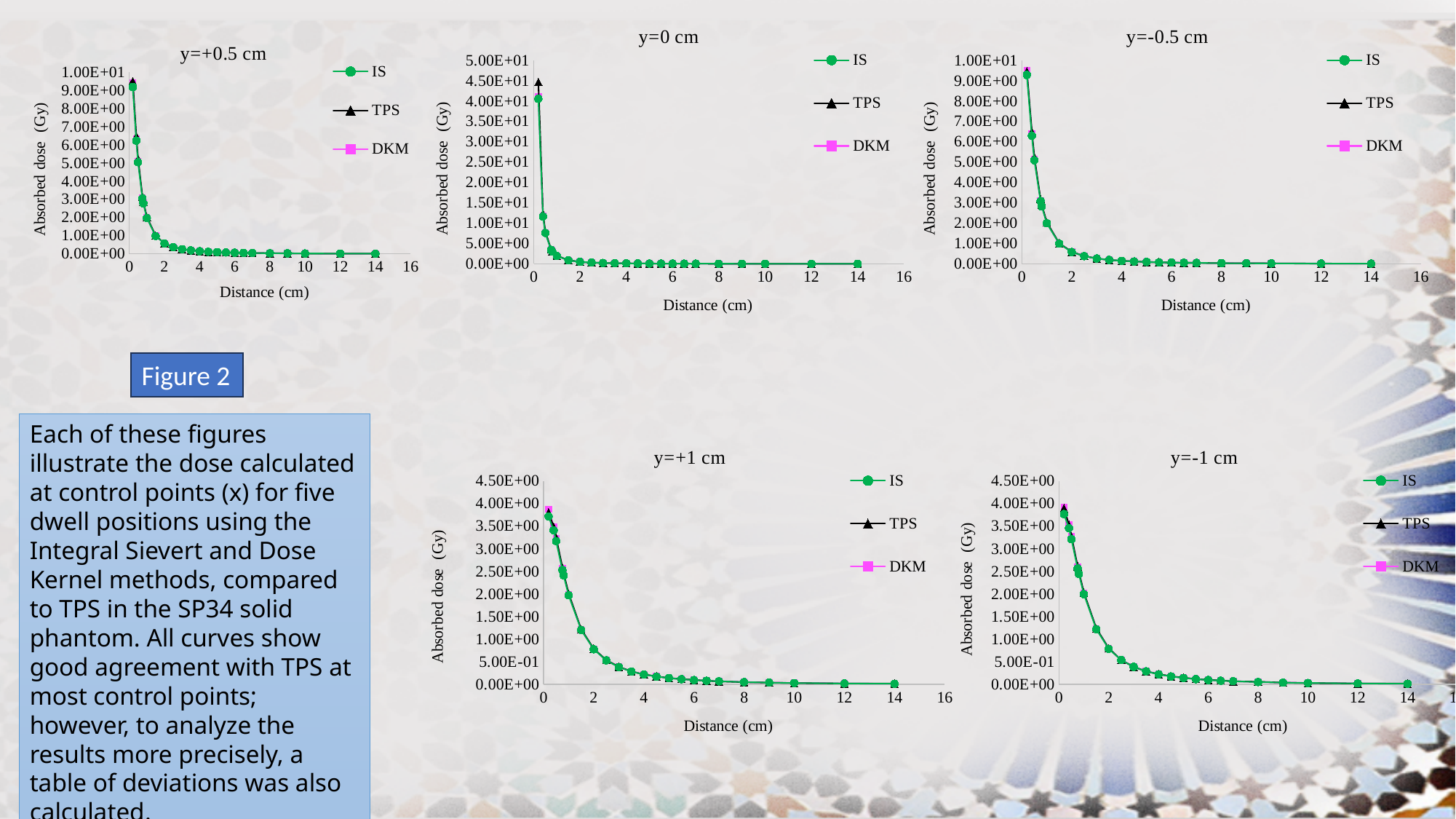
In the "y=0 cm" chart, do the absorbed dose values rise or fall as distance increases? fall How many series does the legend of the "y=+0.5 cm" chart list? 3 What kind of chart is the one titled "y=0 cm"? line chart In the "y=-1 cm" chart, is the IS value at a distance of 2 cm greater or less than 2.00E+00? less In the "y=-0.5 cm" chart, is the IS value at a distance of 10 cm greater or less than 1.00E+00? less What is the x-axis label of the "y=-0.5 cm" chart? Distance (cm) In the "y=0 cm" chart, is the IS value at the first (smallest) distance greater or less than 3.50E+01? greater How many charts are shown on the slide? 5 In the "y=+1 cm" chart, do the values rise or fall along the x axis? fall What are the series names in the legend of the "y=-1 cm" chart? IS, TPS, DKM